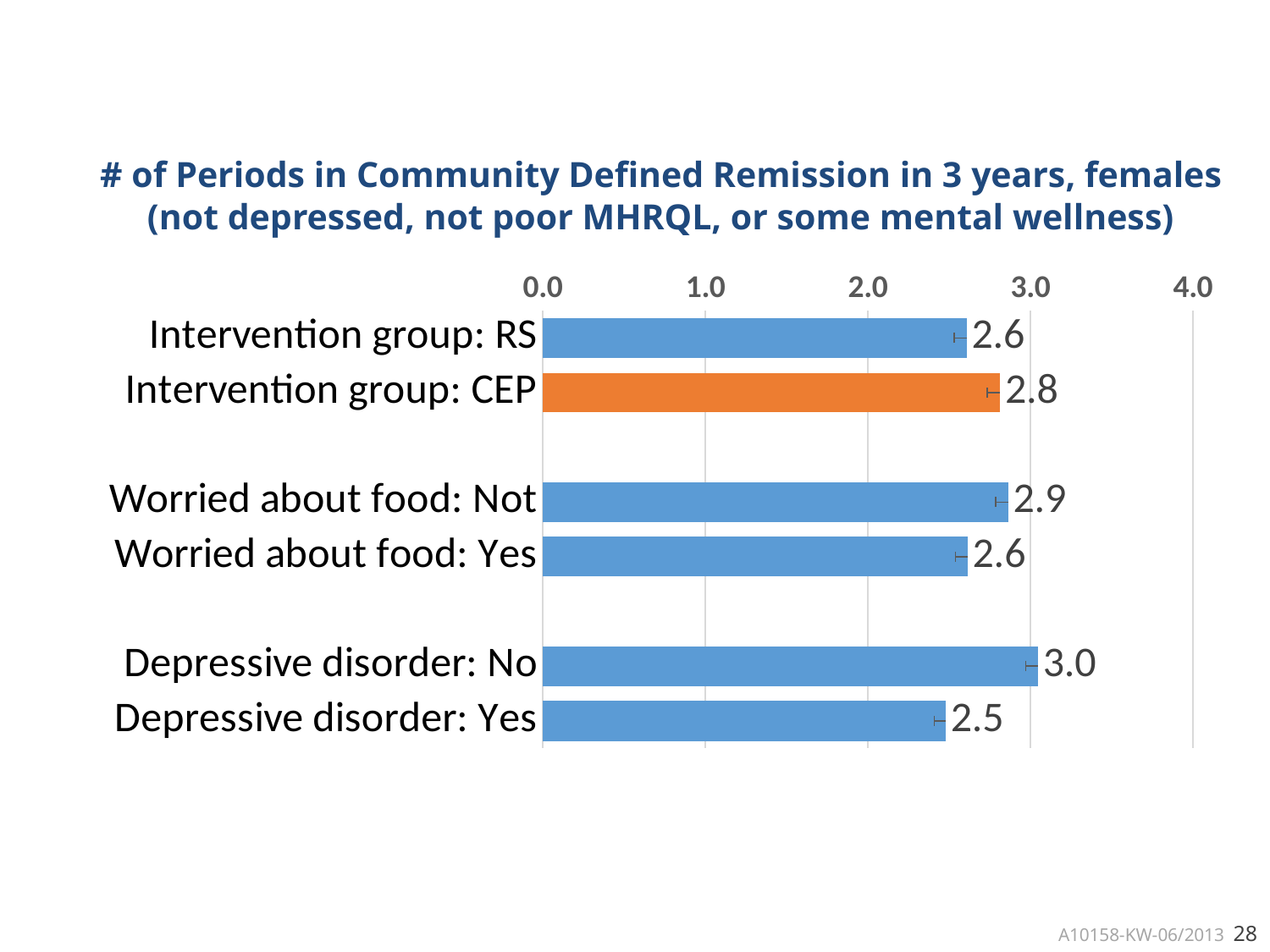
Which bar is coloured orange rather than blue? Intervention group: CEP What is the value for Depressive disorder: No? 3.0 Which category has the lowest value? Depressive disorder: Yes What is the value for Worried about food: Yes? 2.6 What kind of chart is shown on the slide? bar chart Which is larger, Intervention group: RS or Intervention group: CEP? Intervention group: CEP What is the difference between Depressive disorder: No and Depressive disorder: Yes? 0.5 What is the difference between Worried about food: Not and Worried about food: Yes? 0.3 Which category has the highest value? Depressive disorder: No What is the value for Intervention group: CEP? 2.8 Is the value for Depressive disorder: Yes greater or less than 3.0? less How many bars are plotted on the chart? 6